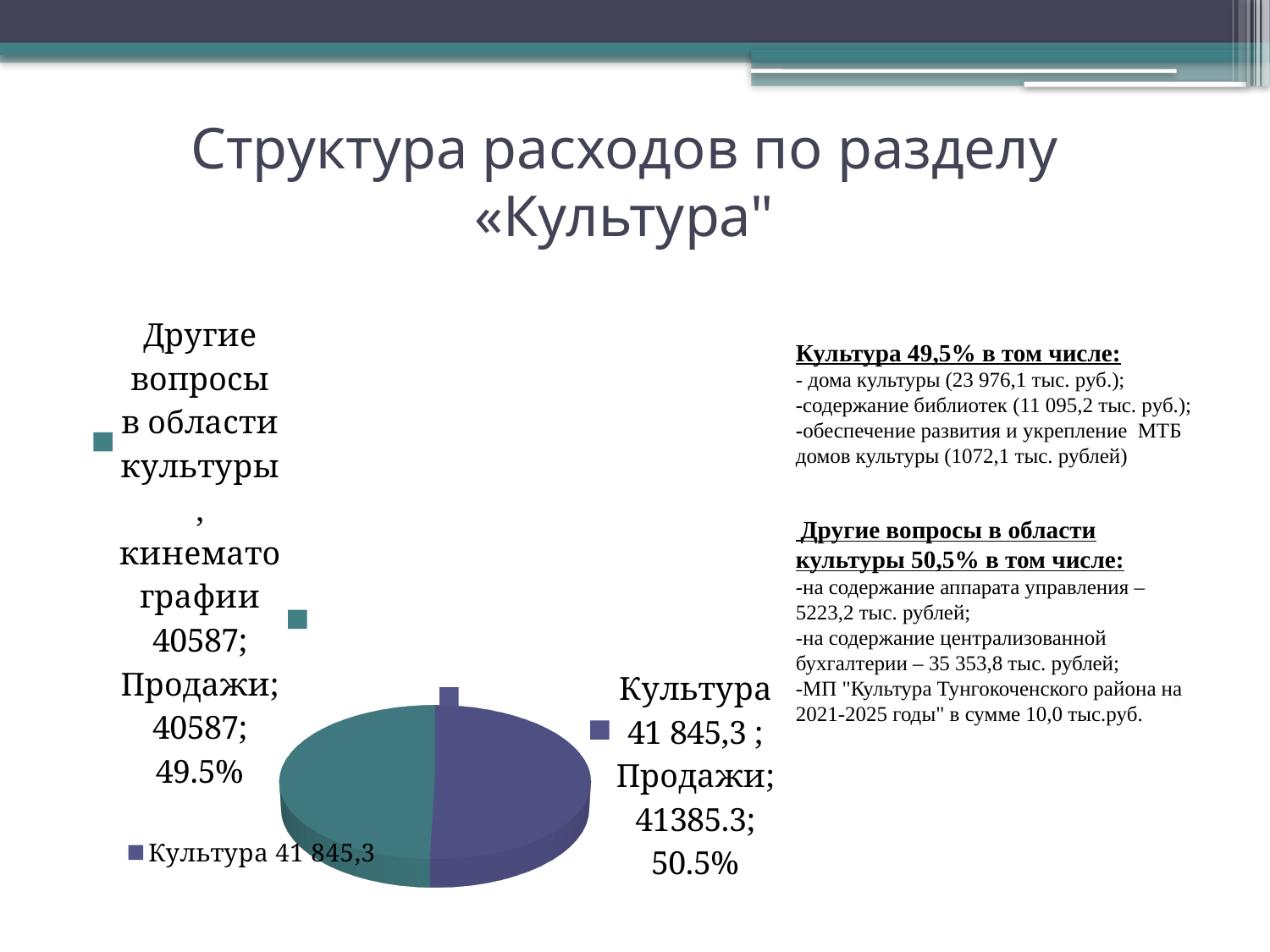
How many slices does the pie chart have? 2 What share of the pie does the "Другие вопросы в области культуры, кинематографии" slice represent? 49.5% What share of the pie does the "Культура" slice represent? 50.5% What kind of chart is shown on the slide? Pie chart What value is printed on the "Культура" slice of the pie chart? 41385.3 Which slice has the smallest share of the pie? Другие вопросы в области культуры, кинематографии What is the difference between the values printed on the "Культура" slice (41385.3) and the "Другие вопросы" slice (40587)? 798.3 What value is printed on the "Другие вопросы в области культуры, кинематографии" slice of the pie chart? 40587 Which slice is larger according to the data labels: "Культура" or "Другие вопросы в области культуры, кинематографии"? Культура What is the title of the slide containing the pie chart? Структура расходов по разделу «Культура" What is the first legend entry shown below the pie chart? Культура 41 845,3